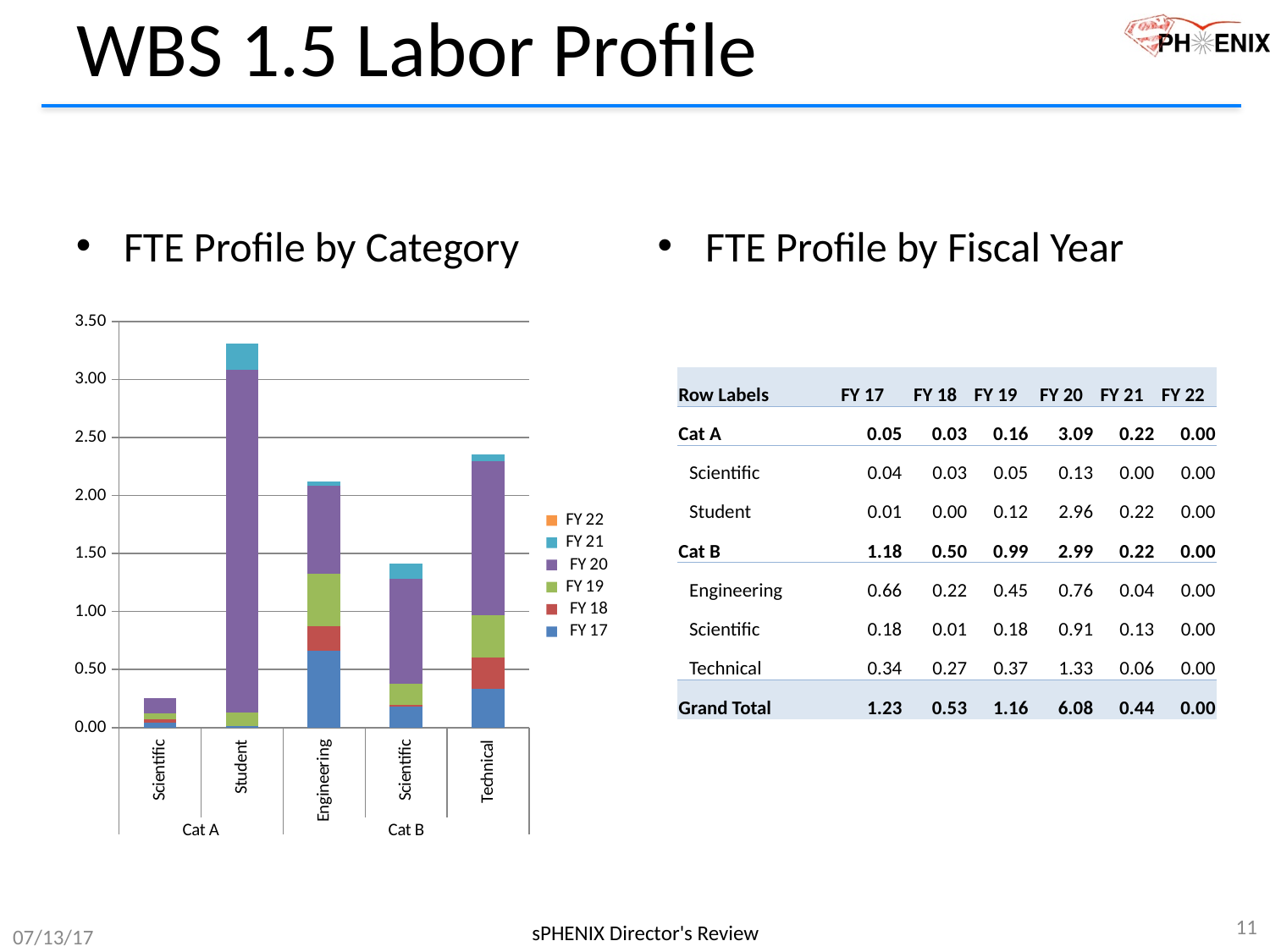
Which bar in the chart is the tallest? Student (Cat A) Is the total height of the Student bar greater or less than 3.00? greater Is the total height of the Engineering bar greater or less than 2.00? greater Is the total height of the Scientific bar under Cat A greater or less than 0.50? less What kind of chart is shown on the slide? Stacked bar chart Which bar in the chart is the shortest? Scientific (Cat A) Which bar is taller, Technical or Engineering? Technical What are the two group labels shown along the bottom of the chart's x axis? Cat A and Cat B How many series does the chart legend list? 6 How many bars (labor categories) are plotted in the chart? 5 Which fiscal year series is shown in purple in the chart? FY 20